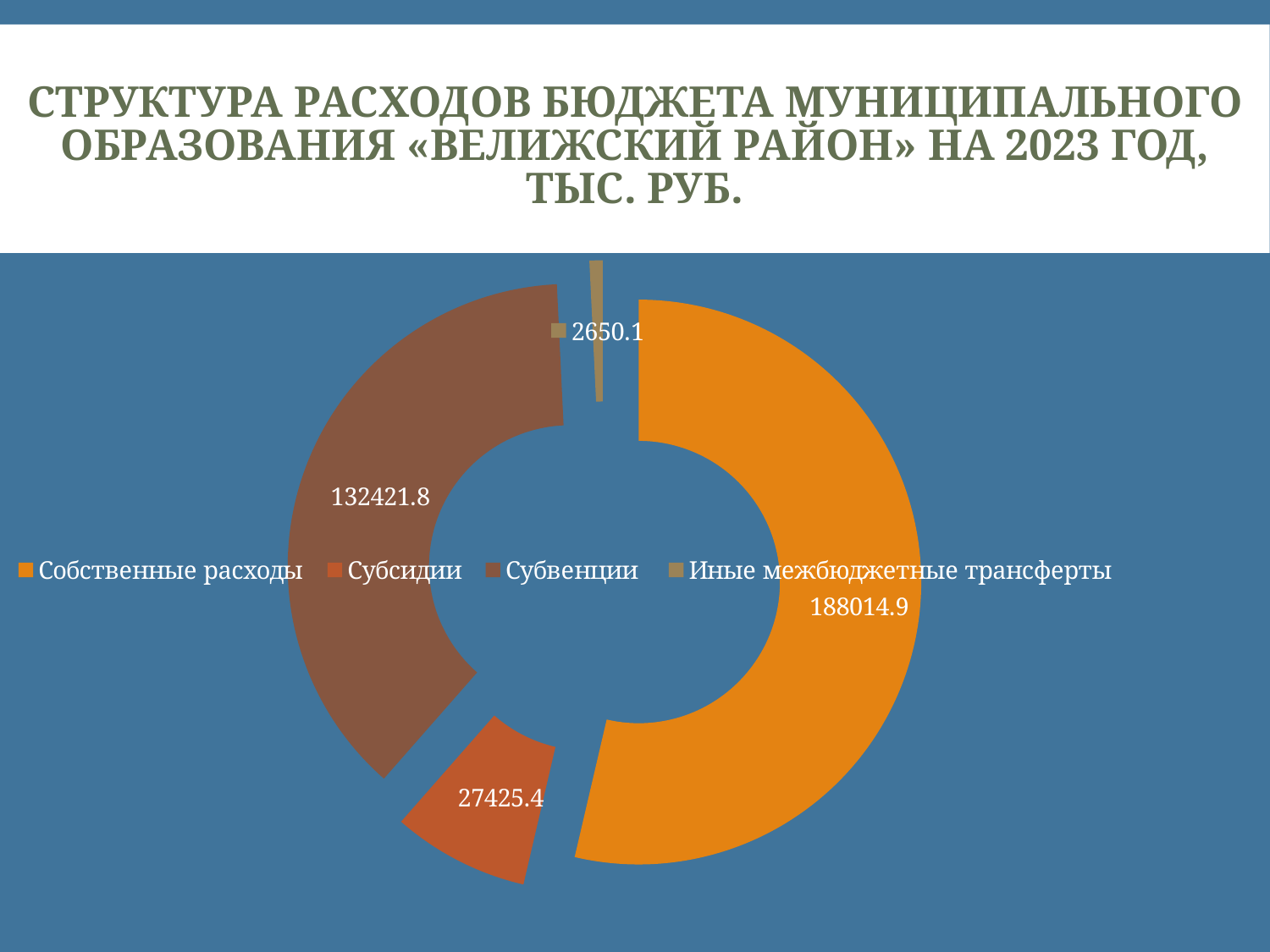
Which is larger, Субвенции or Субсидии? Субвенции Which category has the largest value? Собственные расходы What is the value for Собственные расходы? 188014.9 What colour is the Собственные расходы segment? orange What is the difference between Субсидии and Иные межбюджетные трансферты? 24775.3 What kind of chart is shown on the slide? doughnut chart What is the difference between Собственные расходы and Субвенции? 55593.1 How many categories does the chart show? 4 Which category has the smallest value? Иные межбюджетные трансферты What is the value for Субсидии? 27425.4 What is the value for Субвенции? 132421.8 What is the value for Иные межбюджетные трансферты? 2650.1